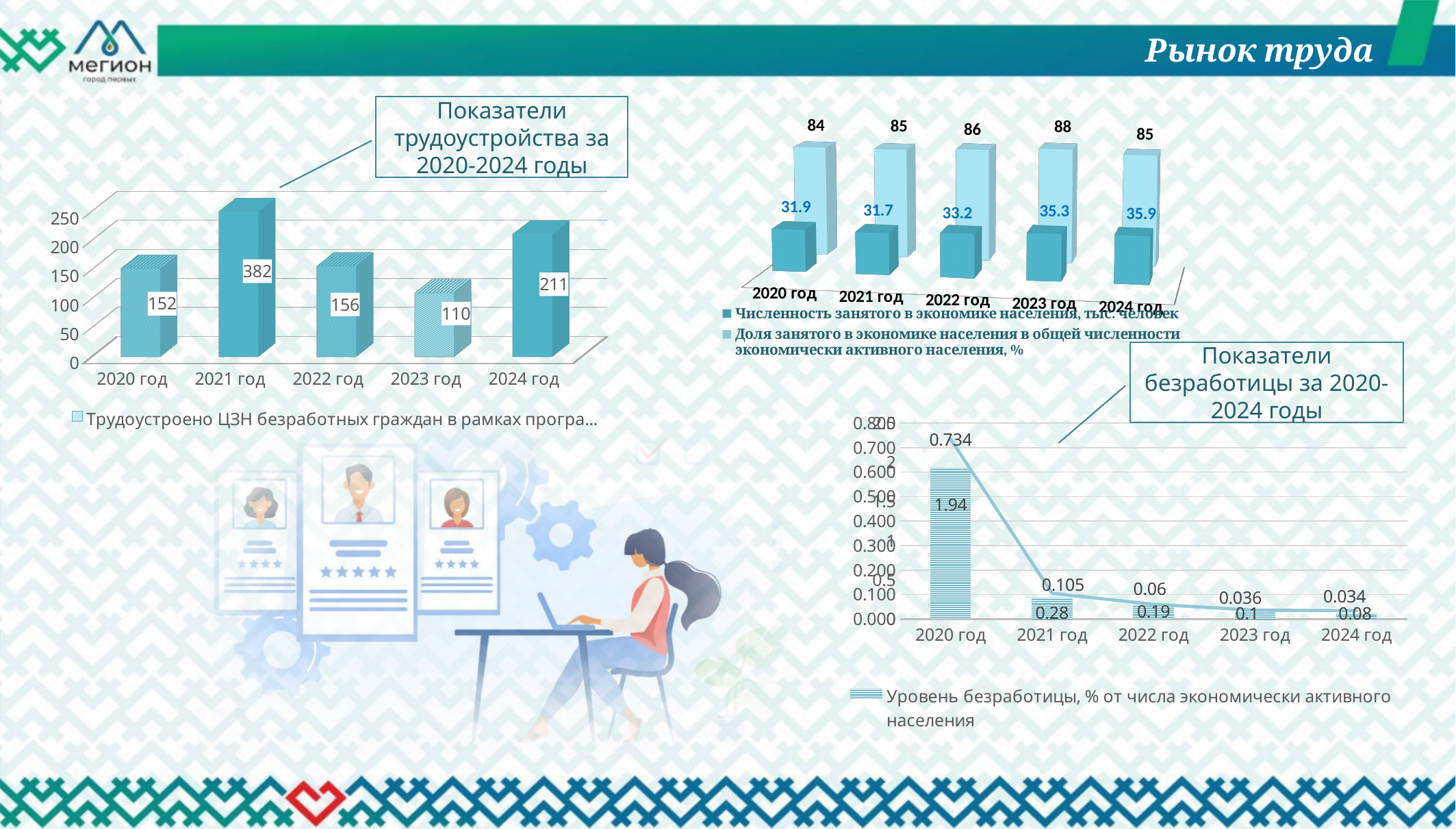
What kind of chart is 'Показатели трудоустройства за 2020-2024 годы'? bar chart In the top-right chart, what is the value of 'Численность занятого в экономике населения, тыс. человек' for 2022 год? 33.2 In the chart titled 'Показатели трудоустройства за 2020-2024 годы', which year has the lowest value? 2023 год In the top-right chart, what is the value of 'Доля занятого в экономике населения в общей численности экономически активного населения, %' for 2023 год? 88 In the chart titled 'Показатели безработицы за 2020-2024 годы', what is the bar value for 2020 год? 1.94 In the chart titled 'Показатели трудоустройства за 2020-2024 годы', what is the value for 2021 год? 382 In the chart titled 'Показатели трудоустройства за 2020-2024 годы', how many years are shown on the x axis? 5 In the chart titled 'Показатели трудоустройства за 2020-2024 годы', which year has the highest value? 2021 год In the top-right chart, does 'Численность занятого в экономике населения, тыс. человек' rise or fall from 2021 год to 2024 год? rise In the chart titled 'Показатели безработицы за 2020-2024 годы', what is the line value for 2023 год? 0.036 In the top-right chart, how many series does the legend list? 2 In the chart titled 'Показатели трудоустройства за 2020-2024 годы', what is the difference between the values for 2024 год and 2020 год? 59